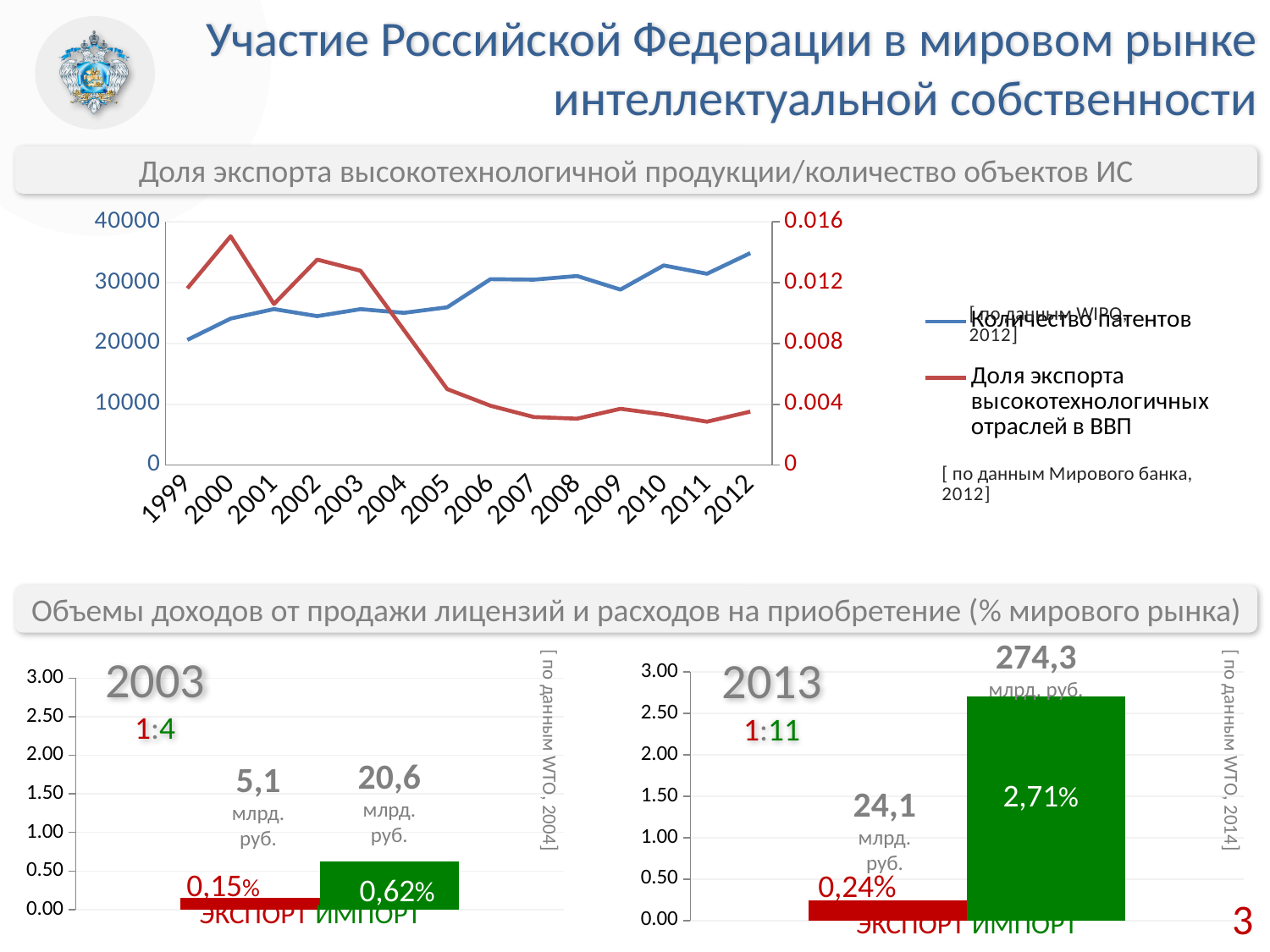
In the top line chart, does the Количество патентов series generally rise or fall from 1999 to 2012? rise In the 2013 bar chart at the bottom right, what is the difference between the ИМПОРТ and ЭКСПОРТ percentages? 2,47% In the 2003 bar chart at the bottom left, what is the value for ИМПОРТ? 0,62% What kind of chart is the top chart titled "Доля экспорта высокотехнологичной продукции/количество объектов ИС"? line chart In the 2013 bar chart at the bottom right, what amount in млрд. руб. is shown for ЭКСПОРТ? 24,1 млрд. руб. In the 2013 bar chart at the bottom right, what is the value for ИМПОРТ? 2,71% In the top line chart, is the value for Количество патентов in 1999 greater or less than 30000? less How many years are plotted along the x axis of the top line chart? 14 How many series does the legend of the top line chart list? 2 In the 2003 bar chart at the bottom left, what is the value for ЭКСПОРТ? 0,15% In the 2013 bar chart at the bottom right, which is larger, ЭКСПОРТ or ИМПОРТ? ИМПОРТ In the top line chart, is the value for Доля экспорта высокотехнологичных отраслей в ВВП in 2000 greater or less than 0.012? greater